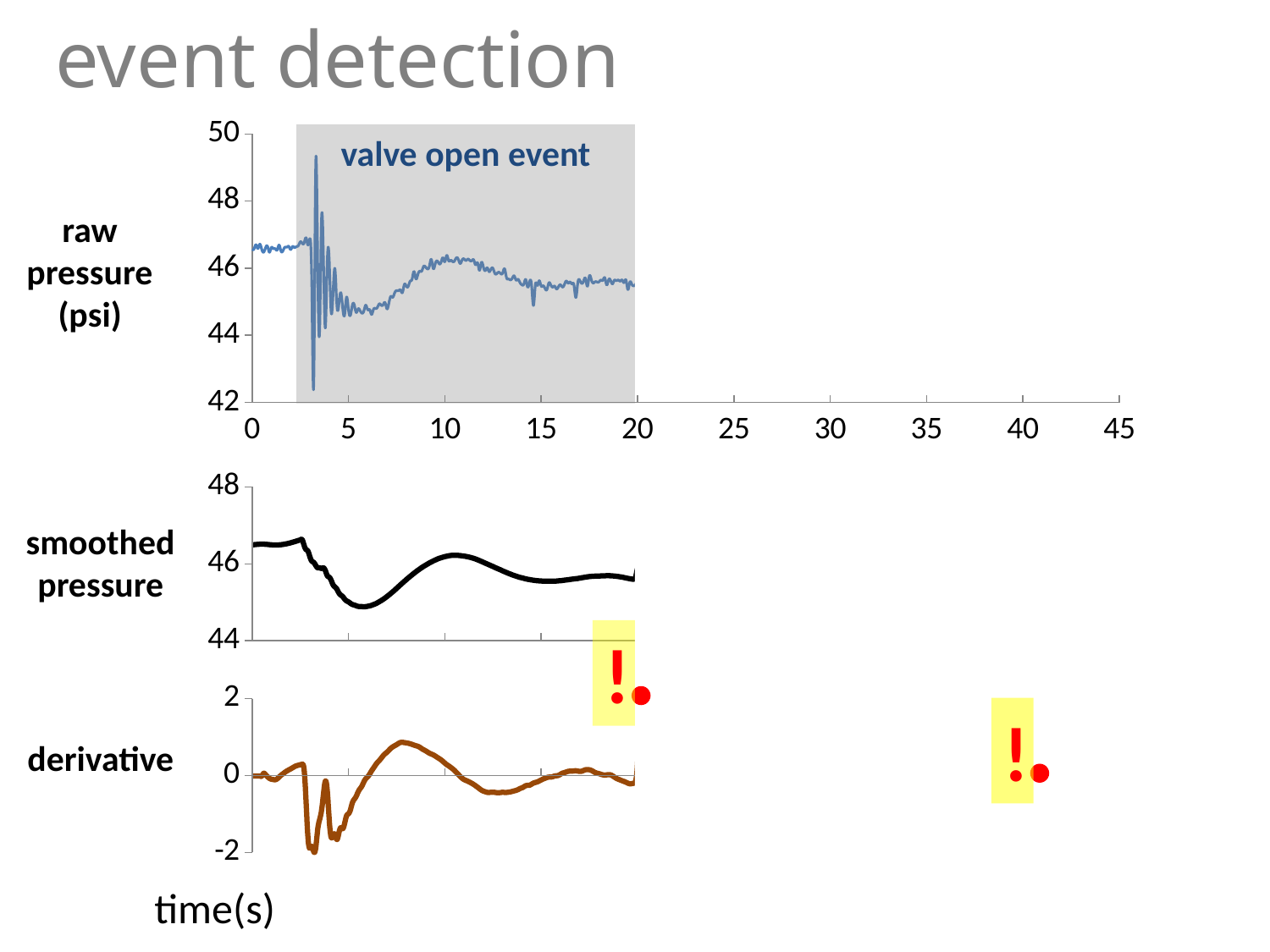
In the raw pressure chart, is the value at time 6 greater or less than 46? less In the smoothed pressure chart, does the line rise or fall between time 6 and time 10? rise How many charts are shown on the slide? 3 In the derivative chart, is the value at time 8 greater or less than 0? greater In the smoothed pressure chart, is the value at time 6 greater or less than 46? less What is the x-axis label shared by the charts on the slide? time(s) In the derivative chart, does the line rise or fall between time 3 and time 8? rise In the raw pressure chart, what label is written inside the shaded grey region? valve open event In the raw pressure chart, what is the highest value shown on the x axis? 45 What kind of chart is the raw pressure chart at the top of the slide? line chart